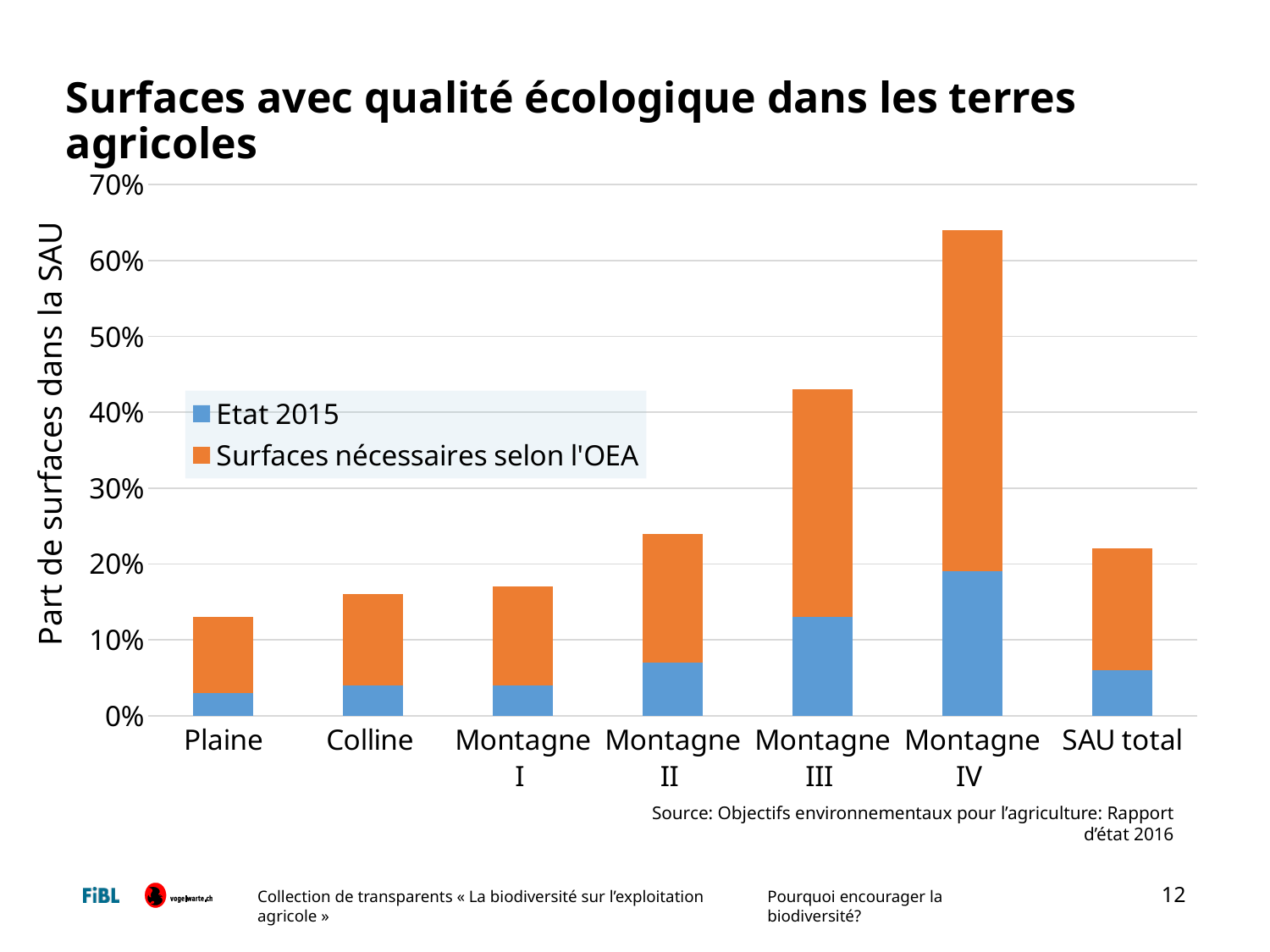
What kind of chart is shown on the slide? Stacked bar chart Is the Etat 2015 value for Montagne III greater or less than 10%? greater How many series does the legend list? 2 Is the total bar for Montagne II greater or less than 30%? less How many categories are shown on the x axis? 7 Which category has the highest total bar? Montagne IV Moving from Plaine through Montagne IV, do the total bars rise or fall? rise Which category has the lowest total bar? Plaine Which has the larger total bar, Montagne III or Montagne II? Montagne III Is the total bar for Montagne IV greater or less than 60%? greater Which category has the largest Etat 2015 value? Montagne IV What is the title of the y axis? Part de surfaces dans la SAU